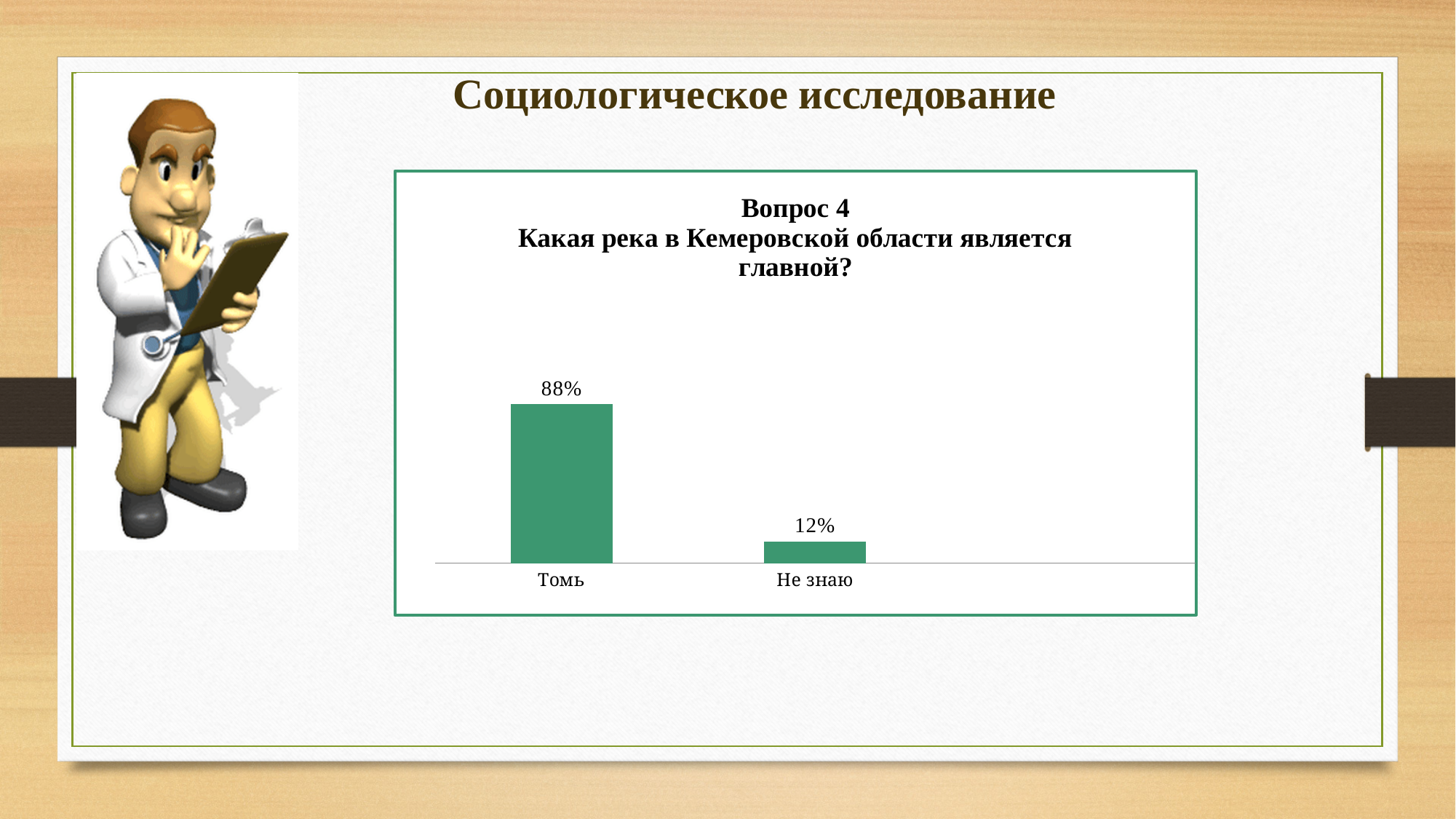
What kind of chart is shown on the slide? Bar chart How many categories are shown in the chart? 2 Which category has the lowest value? Не знаю What is the difference between the values for Томь and Не знаю? 76% Which is larger, the value for Томь or the value for Не знаю? Томь What is the total of the two values shown in the chart? 100% What colour are the bars in the chart? Green What is the value for Томь? 88% Which category has the highest value? Томь What is the value for Не знаю? 12% What is the title of the chart? Вопрос 4 Какая река в Кемеровской области является главной?